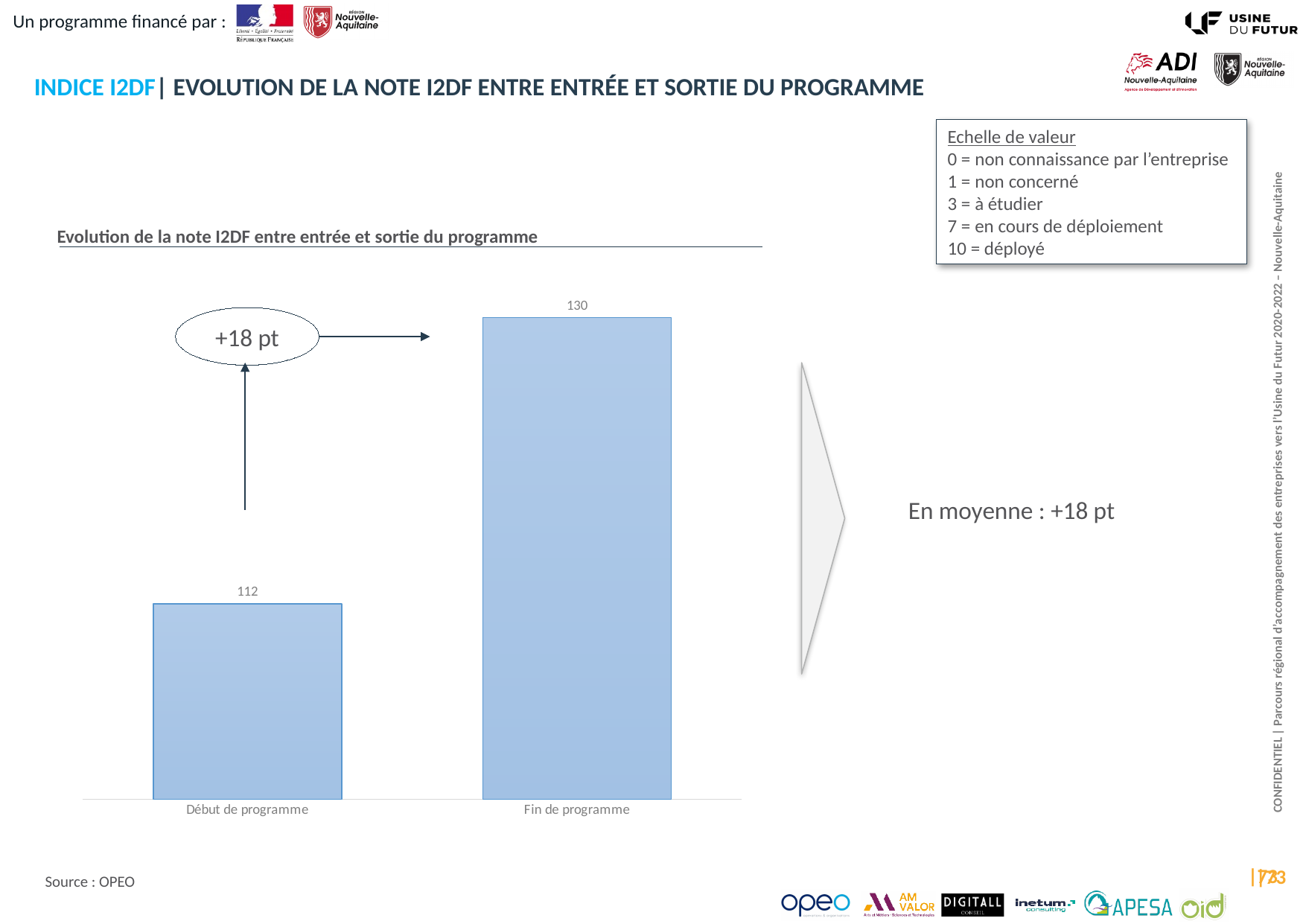
Which category has the lowest value? Début de programme Which category has the highest value? Fin de programme How many categories are shown on the chart? 2 What kind of chart is shown on the slide? Bar chart What is the title of the chart? Evolution de la note I2DF entre entrée et sortie du programme What change in points is annotated on the chart between the two bars? +18 pt What is the value for Fin de programme? 130 What is the difference between the values for Fin de programme and Début de programme? 18 Which is larger, the value for Début de programme or Fin de programme? Fin de programme Do the values rise or fall from Début de programme to Fin de programme? Rise What is the value for Début de programme? 112